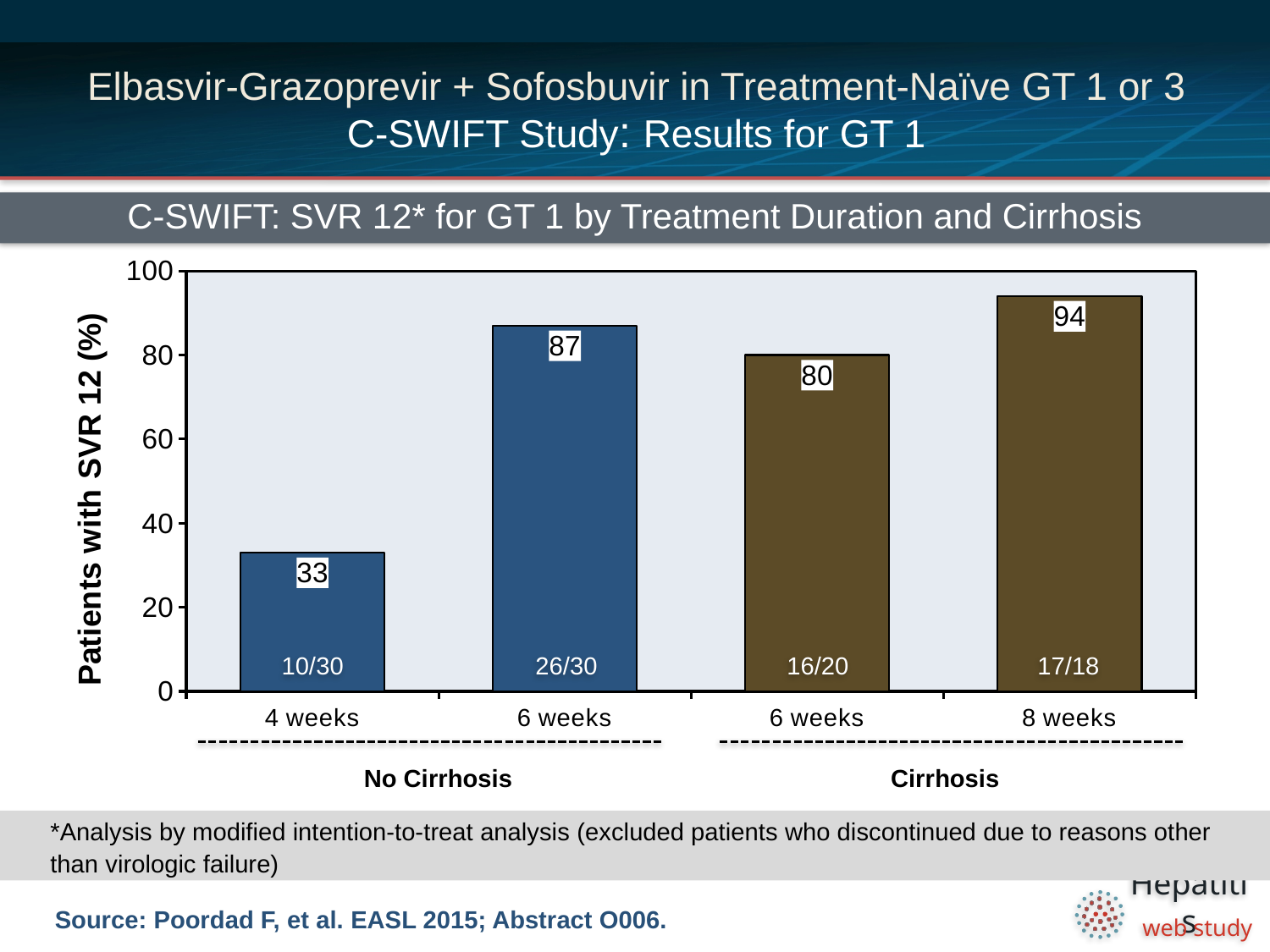
How many patients achieved SVR 12 out of the total in the 6 weeks No Cirrhosis group? 26/30 How many bars are shown in the chart? 4 What type of chart is shown on the slide? Bar chart What is the difference in SVR 12 rate between the 6 weeks and 4 weeks No Cirrhosis groups? 54 Which group has the highest SVR 12 rate? 8 weeks, Cirrhosis What is the SVR 12 rate for the 6 weeks Cirrhosis group? 80 What is the SVR 12 rate for the 4 weeks No Cirrhosis group? 33 Which group has the lowest SVR 12 rate? 4 weeks, No Cirrhosis Which has a higher SVR 12 rate: 6 weeks No Cirrhosis or 6 weeks Cirrhosis? 6 weeks No Cirrhosis Is the SVR 12 rate for the 6 weeks Cirrhosis group greater or less than 60? greater What is the title of the chart? C-SWIFT: SVR 12* for GT 1 by Treatment Duration and Cirrhosis What is the SVR 12 rate for the 8 weeks Cirrhosis group? 94